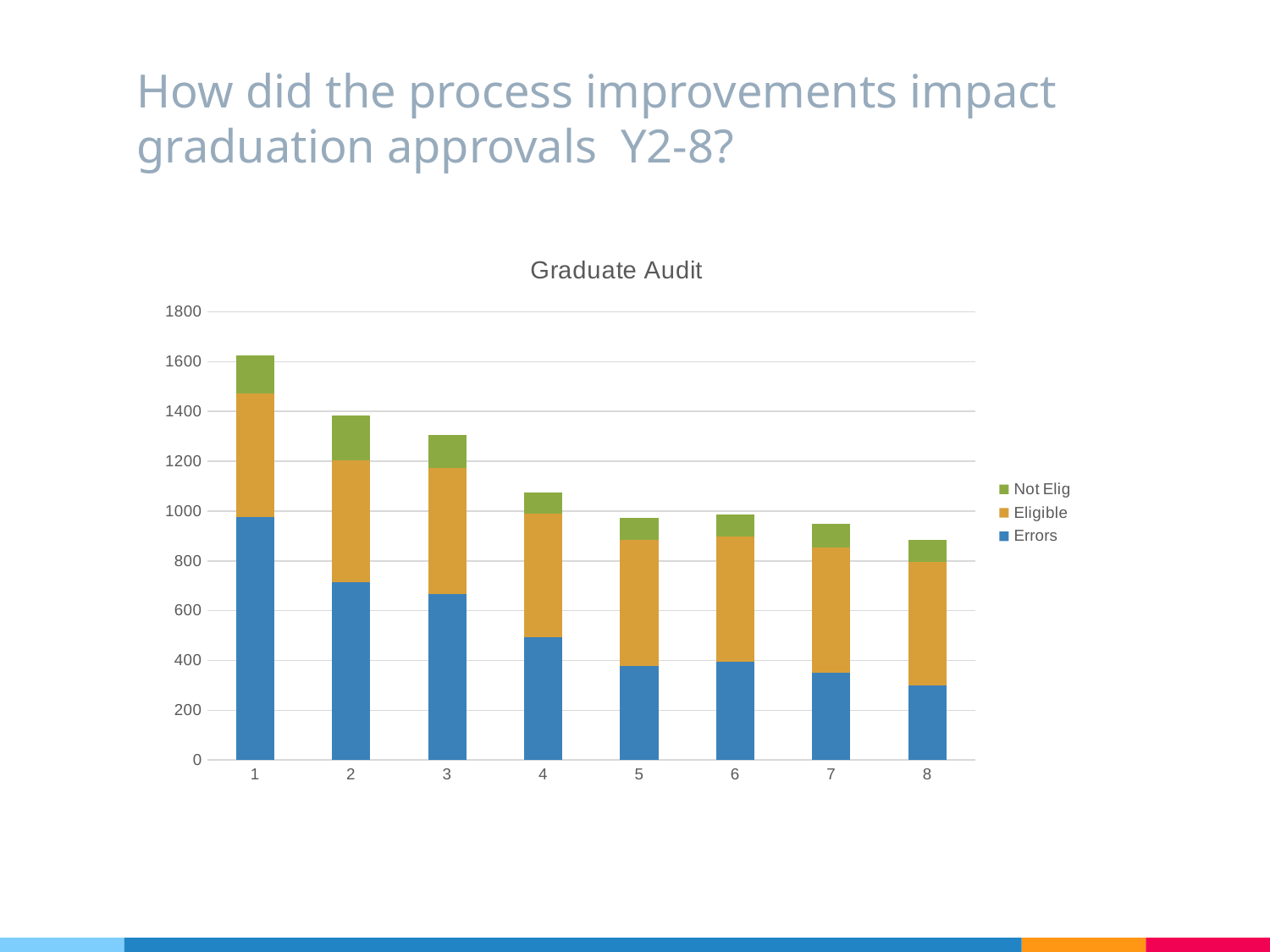
Is the total stacked bar for category 4 greater or less than 1000? greater Is the Errors value for category 1 greater or less than 800? greater How many categories are shown on the x axis? 8 Which has the larger total stacked bar, category 2 or category 3? 2 What kind of chart is shown on the slide? Stacked bar chart Which category has the shortest stacked bar overall? 8 How many series does the legend list? 3 Which category has the tallest stacked bar overall? 1 Is the Errors value for category 8 greater or less than 400? less What is the title of the chart? Graduate Audit Which category has the largest Errors value? 1 Do the Errors values generally rise or fall from category 1 to category 8? fall